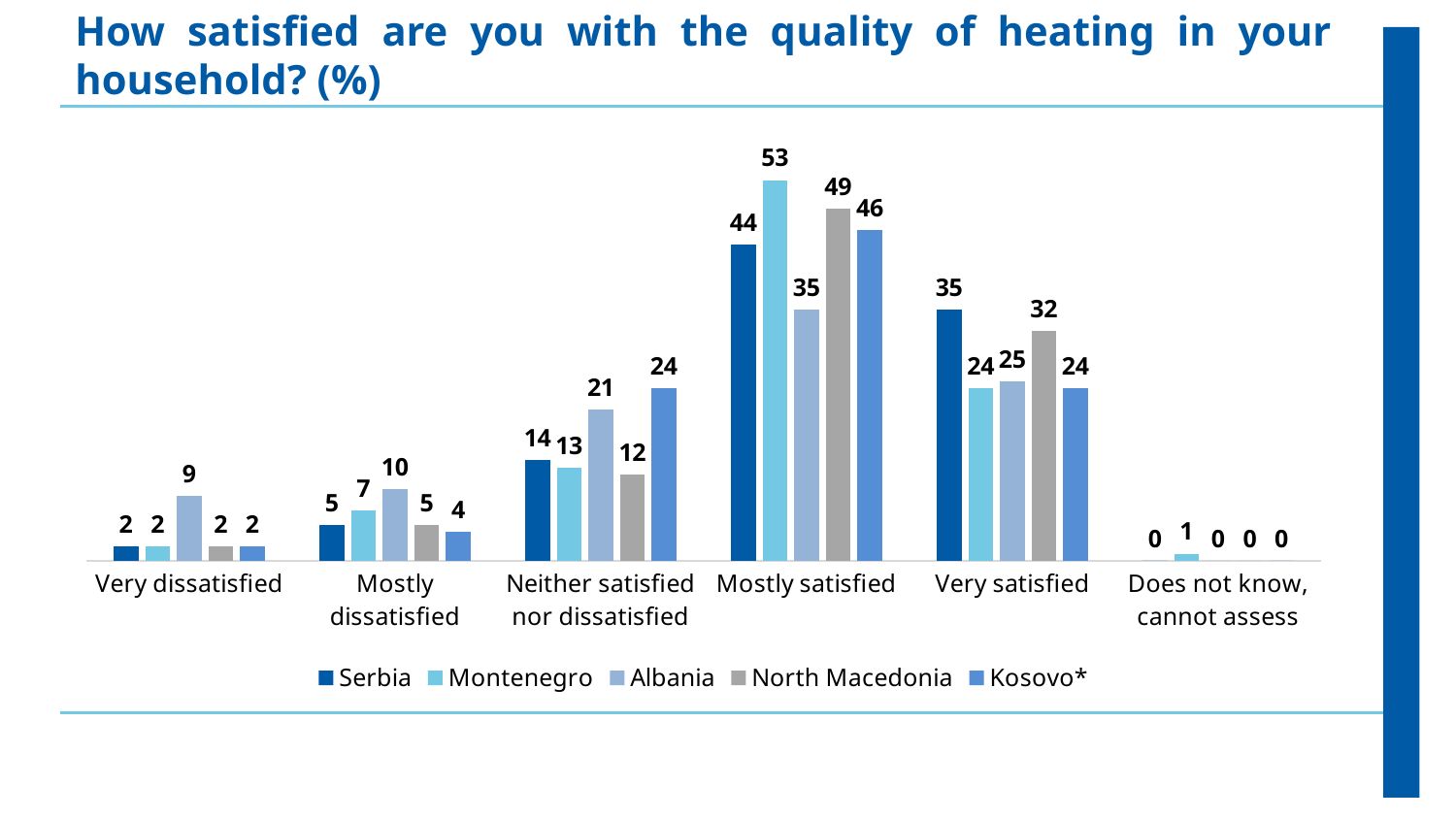
What is the difference between Montenegro and Albania in the Mostly satisfied category? 18 How many series does the legend list? 5 What kind of chart is shown on the slide? Bar chart Which is larger in the Mostly dissatisfied category: Albania or Serbia? Albania Which series is shown in grey in the legend? North Macedonia Which country has the lowest value in the Mostly satisfied category? Albania Which country has the highest value in the Very satisfied category? Serbia What is the value for Montenegro in the Mostly satisfied category? 53 What is the value for Montenegro in the Does not know, cannot assess category? 1 What is the value for Albania in the Very dissatisfied category? 9 What is the value for Kosovo* in the Neither satisfied nor dissatisfied category? 24 How many response categories are shown on the x axis? 6